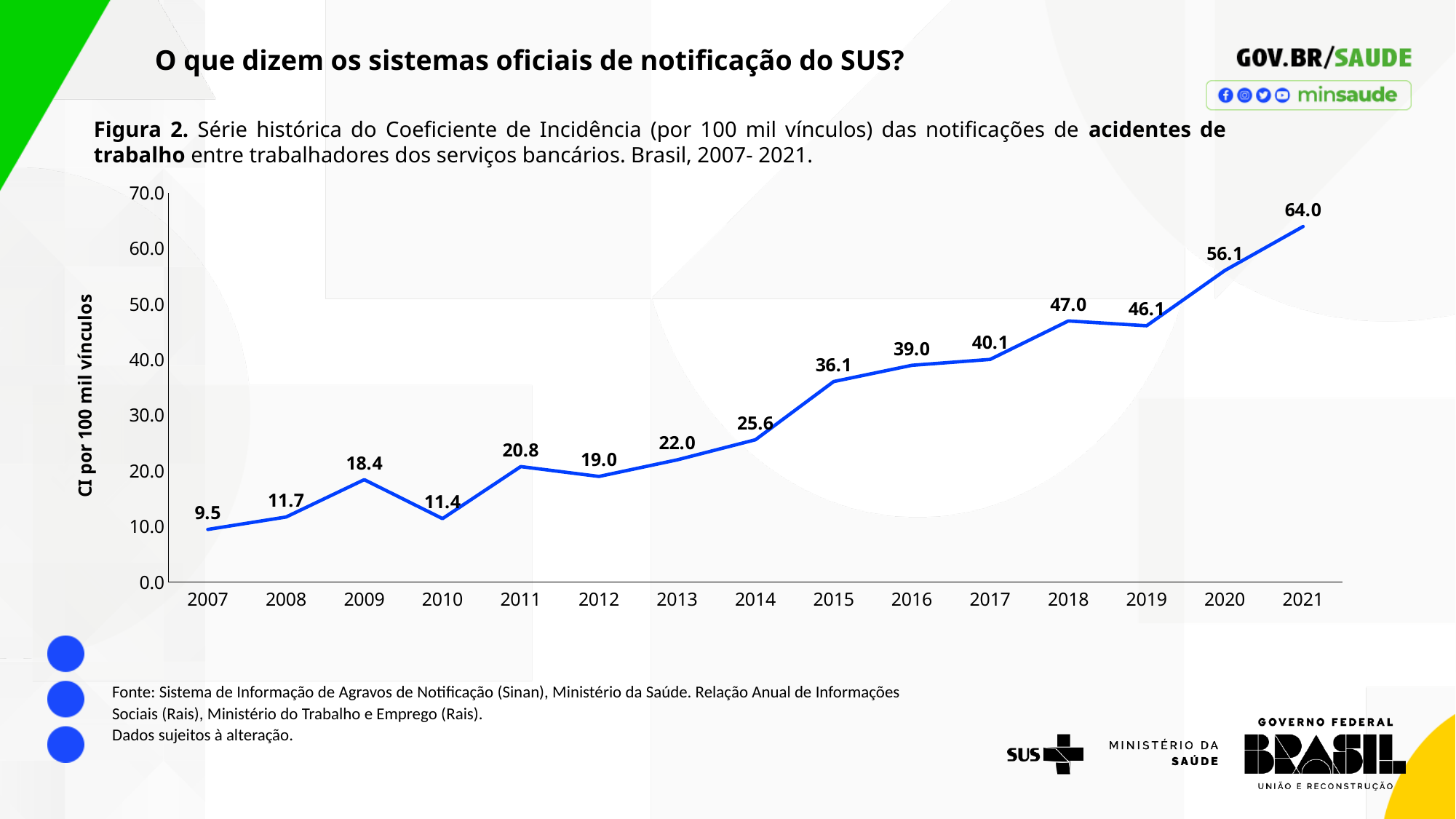
What is the value for 2007? 9.5 Which is larger, the value for 2018 or the value for 2019? 2018 What is the label of the y axis? CI por 100 mil vínculos Is the value for 2014 greater or less than 30.0? less What is the difference between the values for 2021 and 2020? 7.9 Which year has the highest value? 2021 What is the difference between the values for 2009 and 2010? 7.0 What is the value for 2019? 46.1 What kind of chart is shown? line chart What is the value for 2015? 36.1 How many years are plotted on the x axis? 15 Which year has the lowest value? 2007